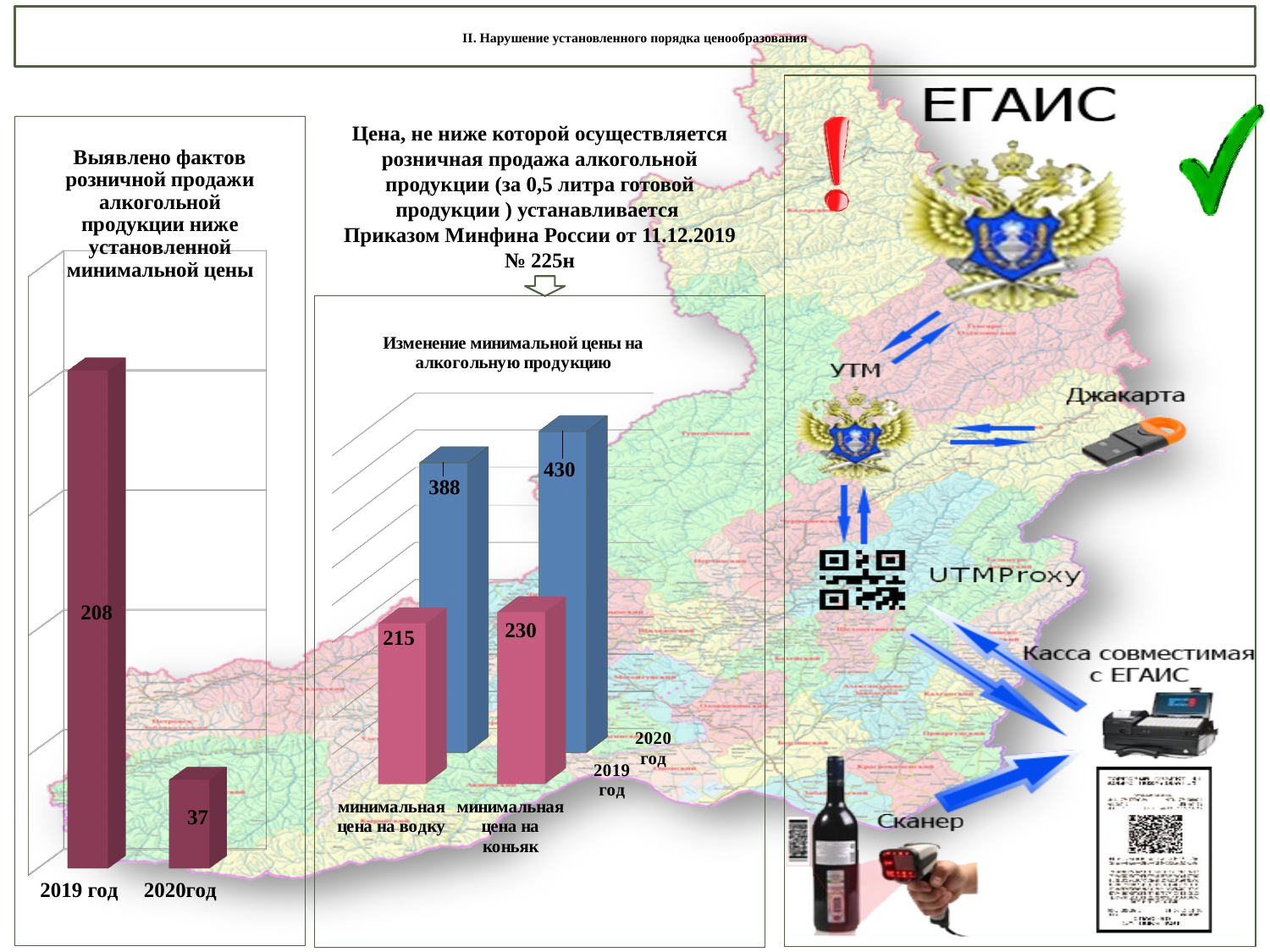
In the left chart 'Выявлено фактов розничной продажи...', how many bars are plotted? 2 In the chart 'Изменение минимальной цены на алкогольную продукцию', what is the minimum price for vodka (минимальная цена на водку) in 2019 год? 215 In the left chart 'Выявлено фактов розничной продажи...', by how much did the value fall from 2019 год to 2020 год? 171 In the chart 'Изменение минимальной цены на алкогольную продукцию', by how much did the minimum price for vodka increase from 2019 год to 2020 год? 173 In the chart 'Изменение минимальной цены на алкогольную продукцию', which is higher in 2020 год: the minimum price for vodka or for cognac? минимальная цена на коньяк In the chart 'Изменение минимальной цены на алкогольную продукцию', how many years (series) are shown? 2 In the chart 'Изменение минимальной цены на алкогольную продукцию', what is the minimum price for cognac (минимальная цена на коньяк) in 2020 год? 430 What type of chart is the left chart 'Выявлено фактов розничной продажи...'? bar chart In the left chart 'Выявлено фактов розничной продажи алкогольной продукции ниже установленной минимальной цены', what is the value for 2019 год? 208 In the left chart 'Выявлено фактов розничной продажи...', which year has the higher value? 2019 год In the chart 'Изменение минимальной цены на алкогольную продукцию', by how much did the minimum price for cognac increase from 2019 год to 2020 год? 200 In the left chart 'Выявлено фактов розничной продажи алкогольной продукции ниже установленной минимальной цены', what is the value for 2020 год? 37